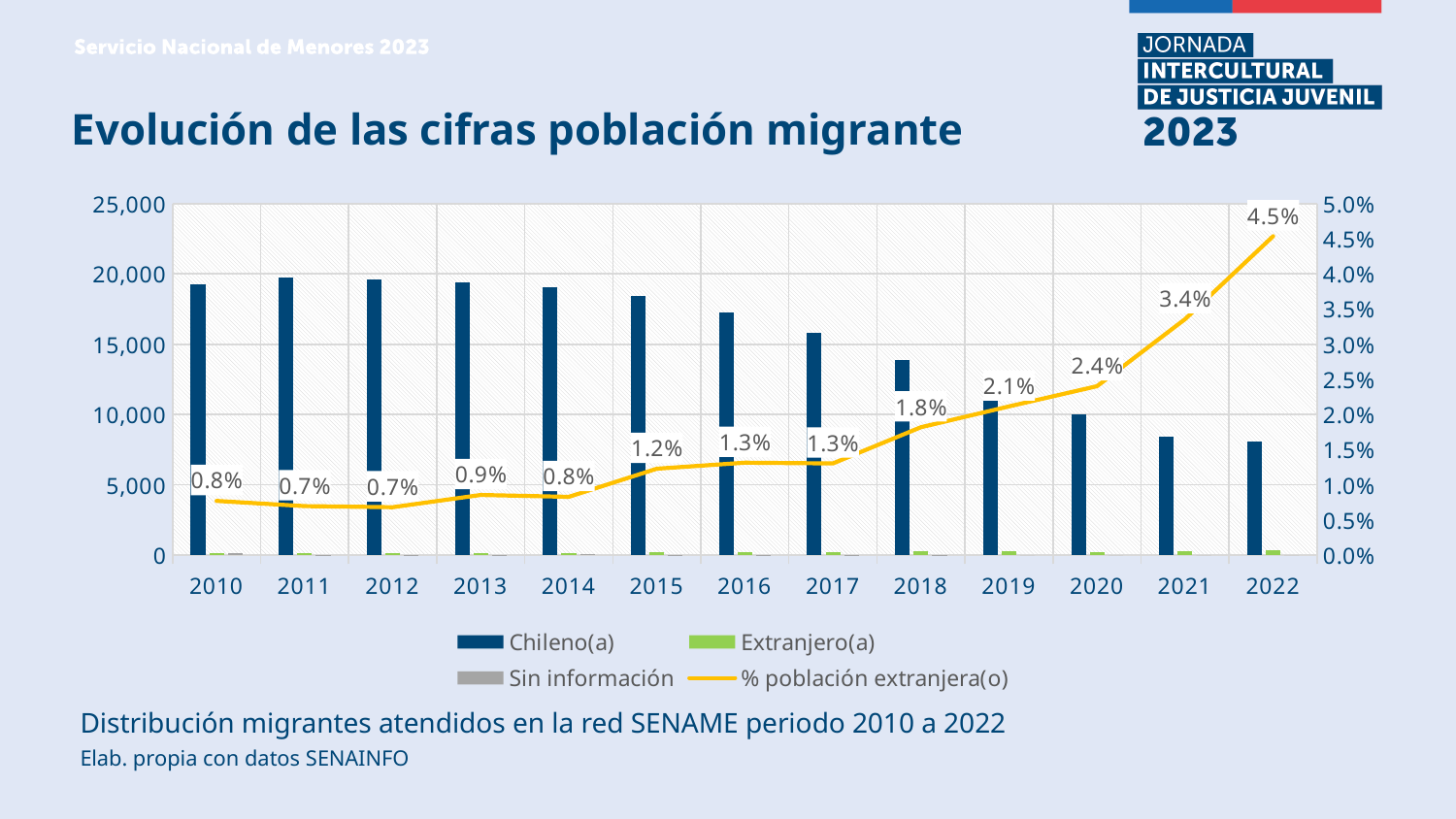
What is the value of % población extranjera(o) for 2018? 1.8% What is the value of % población extranjera(o) for 2022? 4.5% In which year is % población extranjera(o) highest? 2022 Is the Chileno(a) value for 2022 greater or less than 10,000? less How many years are shown on the x axis? 13 What is the value of % población extranjera(o) for 2021? 3.4% What is the difference between % población extranjera(o) in 2022 and in 2010? 3.7% Is the Chileno(a) value for 2010 greater or less than 15,000? greater What is the value of % población extranjera(o) for 2010? 0.8% Which is larger, % población extranjera(o) in 2018 or in 2015? 2018 Does the % población extranjera(o) line rise or fall from 2010 to 2022? rise How many series does the legend list? 4